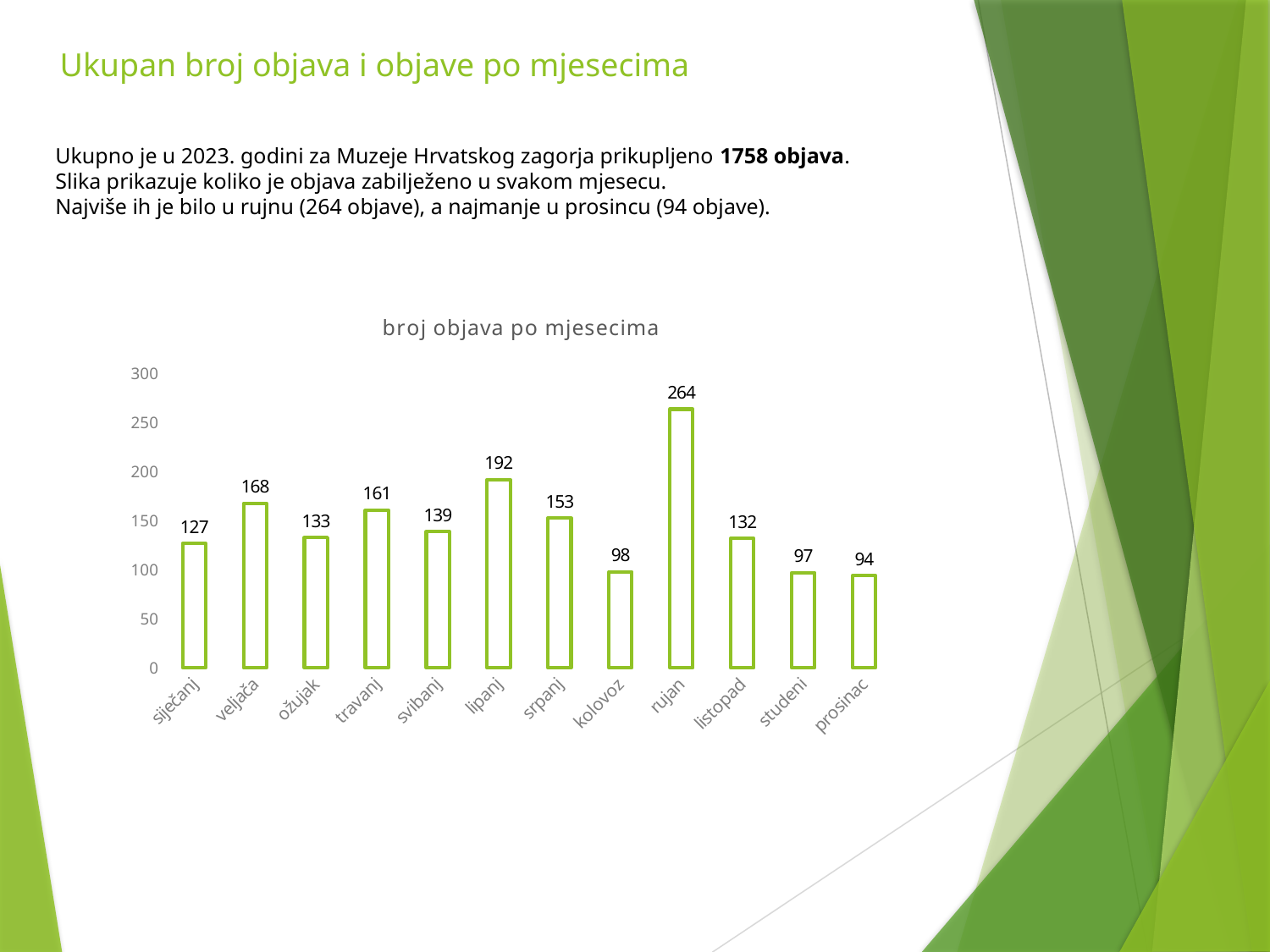
What is the difference between the values for veljača and ožujak? 35 What is the value for siječanj in the chart? 127 Which month has the highest value in the chart? rujan What is the value for rujan in the chart? 264 How many months are shown on the x axis of the chart? 12 Is the value for kolovoz greater or less than 100? less What kind of chart is shown on the slide? bar chart Which is larger, the value for travanj or the value for svibanj? travanj What is the difference between the values for rujan and prosinac? 170 Which month has the lowest value in the chart? prosinac What is the title of the chart? broj objava po mjesecima What is the value for lipanj in the chart? 192